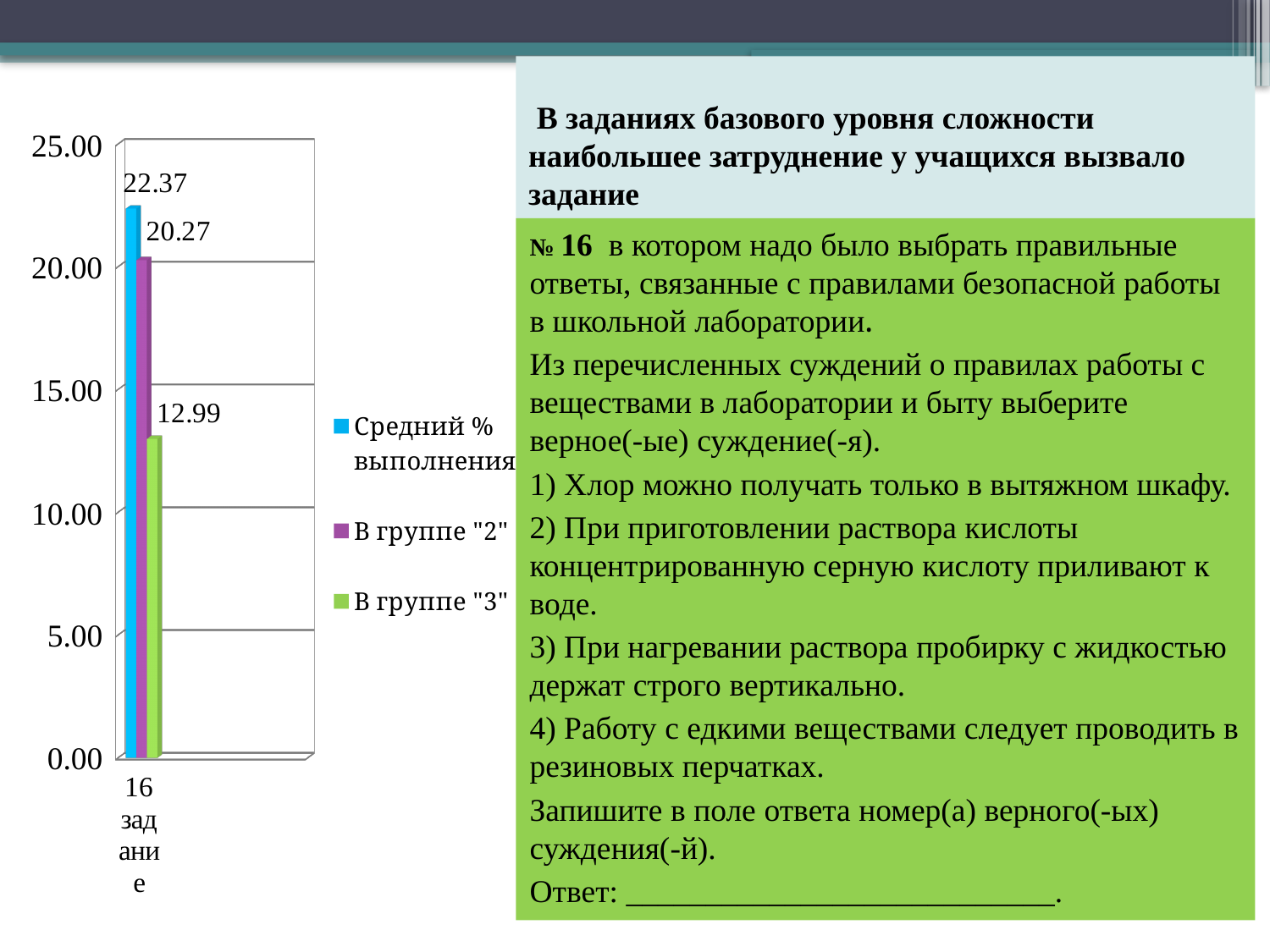
What is the difference between the "Средний % выполнения" value and the "В группе "2"" value? 2.10 What is the difference between the "Средний % выполнения" value and the "В группе "3"" value? 9.38 How many series does the legend list? 3 What is the value of the "Средний % выполнения" series for "16 задание"? 22.37 What is the value of the "В группе "2"" series for "16 задание"? 20.27 What kind of chart is shown on the slide? bar chart Which is larger: the value for "В группе "2"" or the value for "В группе "3""? В группе "2" Which series has the highest value on the chart? Средний % выполнения How many categories are shown on the x axis? 1 What is the value of the "В группе "3"" series for "16 задание"? 12.99 Which series has the lowest value on the chart? В группе "3" Is the value for "В группе "3"" greater or less than 15.00? less